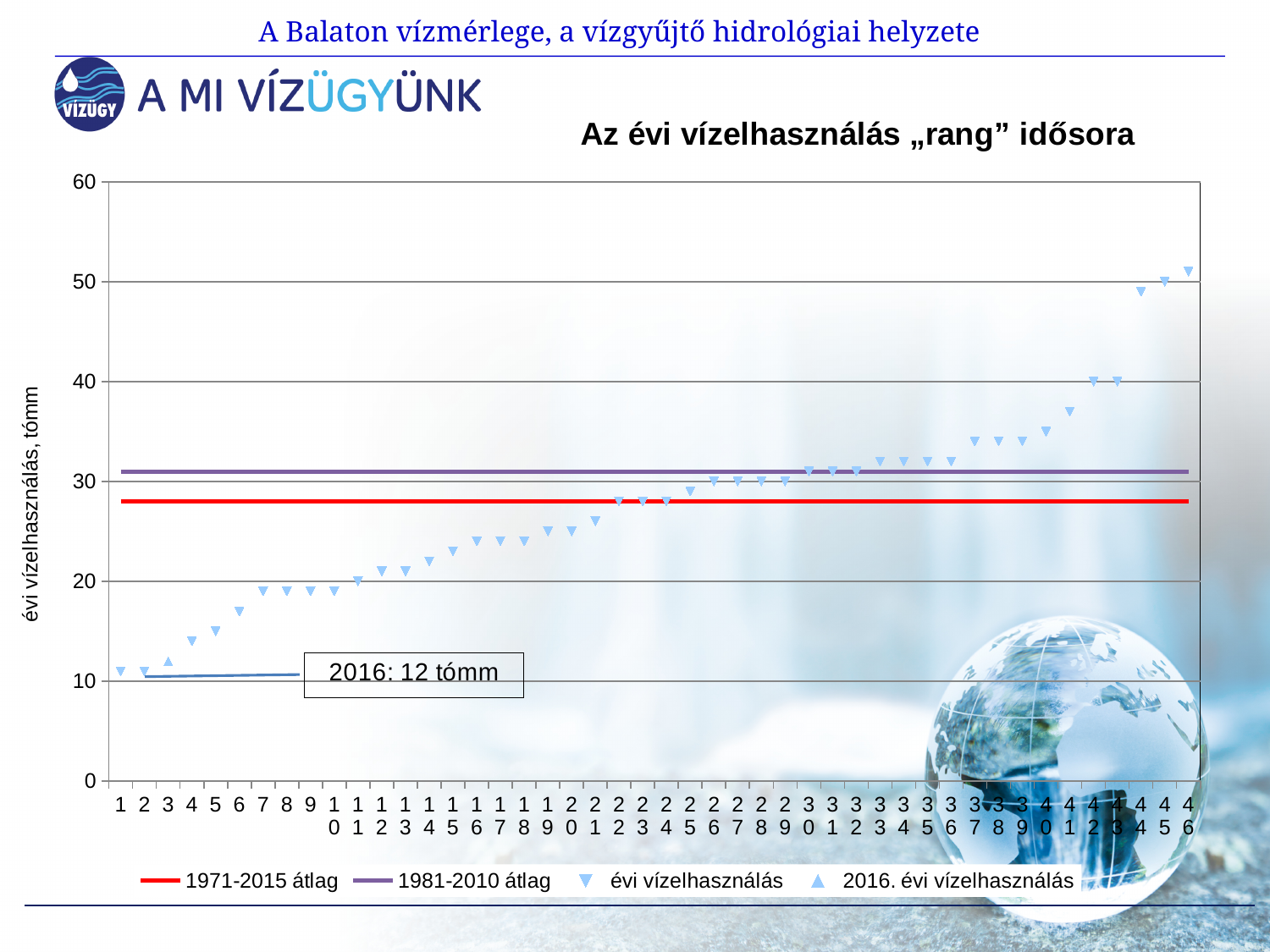
Is the value for rank 41 greater or less than 40? less Is the value for rank 44 greater or less than 50? less Which rank has the highest évi vízelhasználás value? 46 What is the title of the chart? Az évi vízelhasználás „rang” idősora Is the 1971-2015 átlag line greater or less than 30? less How many ranked points are shown on the x axis? 46 What colour is the 1971-2015 átlag line? red Which of the two average lines is higher, 1971-2015 átlag or 1981-2010 átlag? 1981-2010 átlag Do the évi vízelhasználás values rise or fall along the x axis from rank 1 to rank 46? rise How many series does the chart legend list? 4 What is the 2016 annual water use value shown in the annotation box? 12 tómm